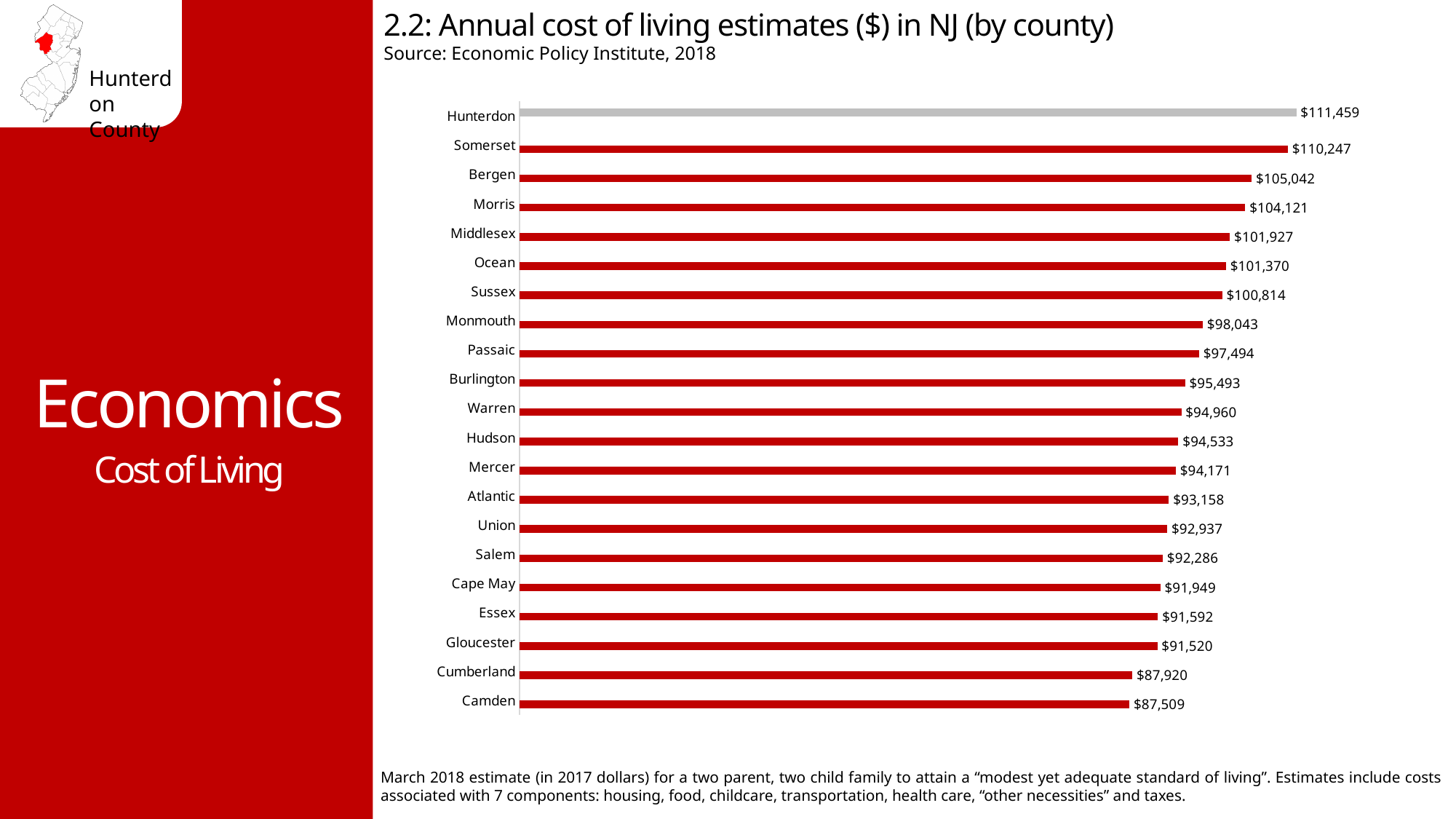
Which county's bar is coloured grey instead of red? Hunterdon Which county has the lowest annual cost of living estimate? Camden What is the annual cost of living estimate for Camden County? $87,509 Which county has a higher cost of living estimate, Morris or Middlesex? Morris What is the difference between the cost of living estimates for Somerset and Bergen? $5,205 How many counties are shown in the chart? 21 What is the difference between the cost of living estimates for Hunterdon and Camden? $23,950 What is the annual cost of living estimate for Monmouth County? $98,043 What is the annual cost of living estimate for Hunterdon County? $111,459 What type of chart is used to show the cost of living estimates? Bar chart Which county has the highest annual cost of living estimate? Hunterdon Which county has a higher cost of living estimate, Essex or Cumberland? Essex